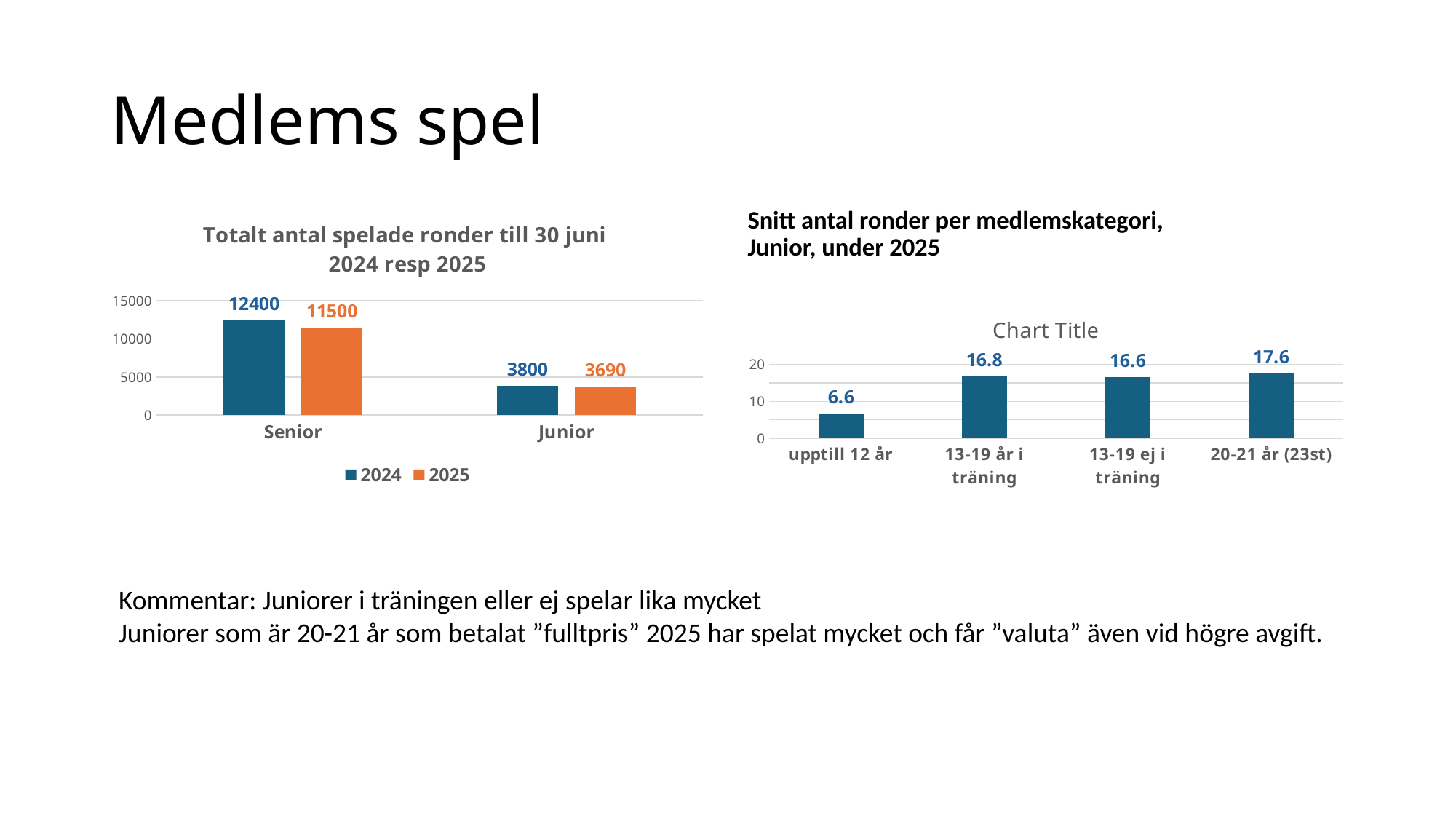
In the right chart (Snitt antal ronder per medlemskategori, Junior, under 2025), which category has the highest value? 20-21 år (23st) In the right chart (Snitt antal ronder per medlemskategori, Junior, under 2025), what is the value for 'upptill 12 år'? 6.6 In the left chart 'Totalt antal spelade ronder till 30 juni 2024 resp 2025', what is the difference between the Senior values for 2024 and 2025? 900 In the left chart 'Totalt antal spelade ronder till 30 juni 2024 resp 2025', which colour represents 2025? Orange In the left chart 'Totalt antal spelade ronder till 30 juni 2024 resp 2025', how many series does the legend list? 2 In the left chart 'Totalt antal spelade ronder till 30 juni 2024 resp 2025', what is the value for Junior in 2025? 3690 In the left chart 'Totalt antal spelade ronder till 30 juni 2024 resp 2025', what is the value for Senior in 2024? 12400 In the right chart (Snitt antal ronder per medlemskategori, Junior, under 2025), how many categories are shown? 4 In the right chart (Snitt antal ronder per medlemskategori, Junior, under 2025), which category has the lowest value? upptill 12 år In the left chart 'Totalt antal spelade ronder till 30 juni 2024 resp 2025', which is larger: Junior in 2024 or Junior in 2025? Junior in 2024 What kind of chart is the right chart (Snitt antal ronder per medlemskategori, Junior, under 2025)? Bar chart In the right chart (Snitt antal ronder per medlemskategori, Junior, under 2025), what is the value for '20-21 år (23st)'? 17.6